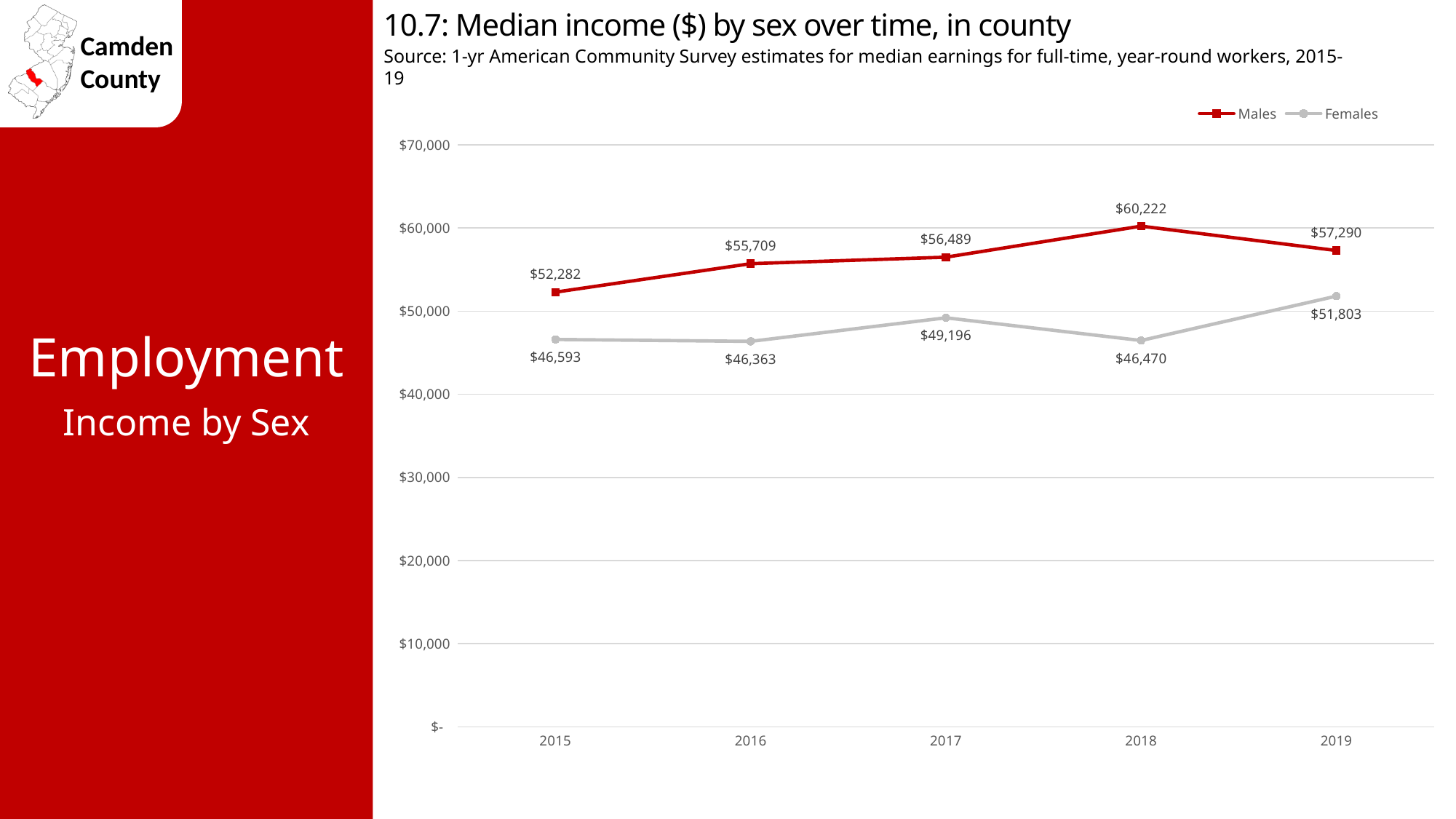
How many years are shown on the x axis? 5 What was the median income for Females in 2017? $49,196 In which year was the median income for Males highest? 2018 What is the difference between Males and Females median income in 2019? $5,487 What kind of chart is shown on the slide? Line chart Was the median income for Females in 2019 greater or less than $50,000? greater Which was higher in 2017, the median income for Males or for Females? Males In which year was the median income for Females lowest? 2016 How many series does the legend list? 2 What was the median income for Females in 2019? $51,803 What was the median income for Males in 2018? $60,222 How much did the Males median income increase from 2015 to 2018? $7,940